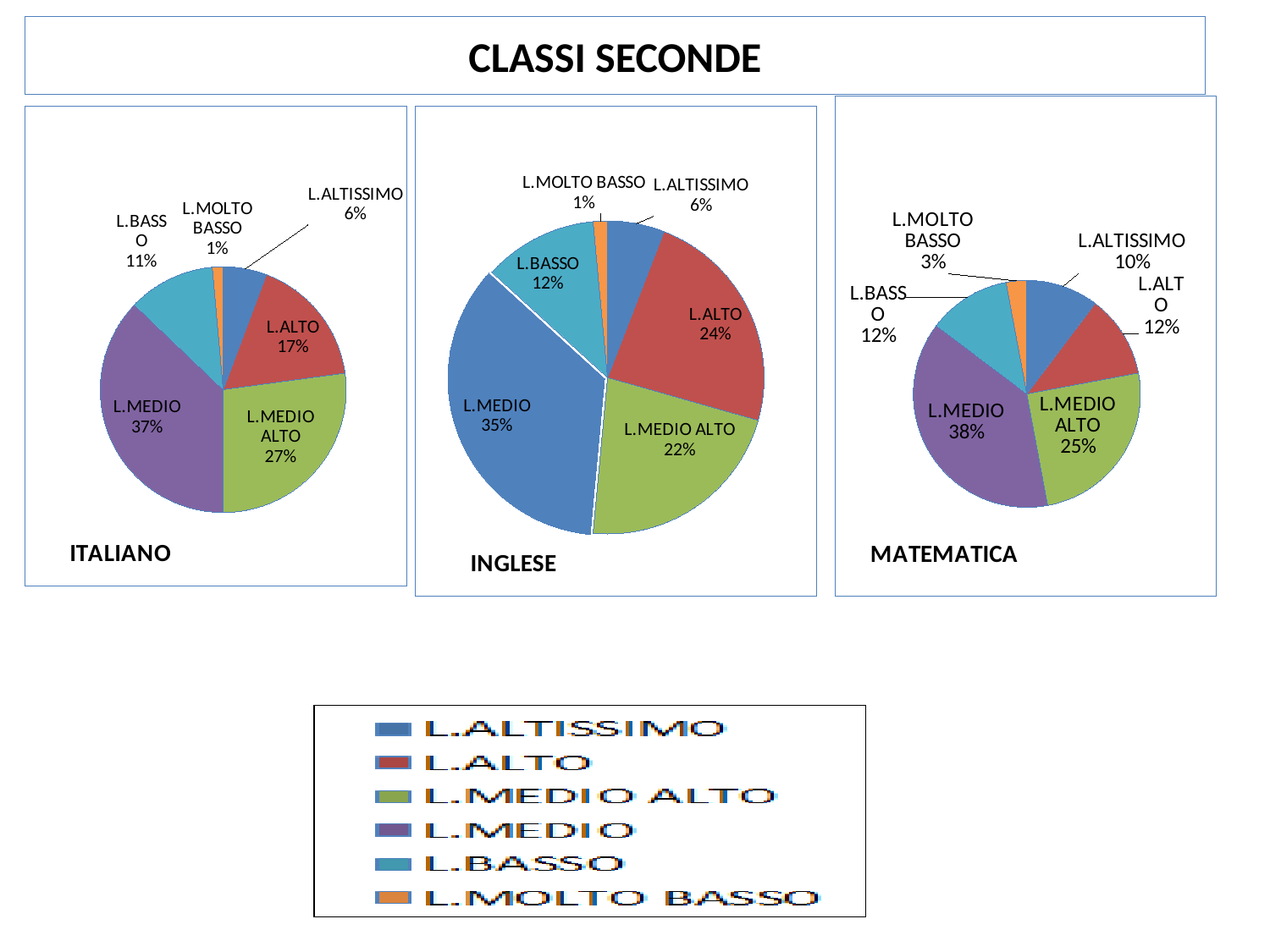
What type of chart is used for ITALIANO, INGLESE and MATEMATICA? Pie chart In the INGLESE pie chart, which category has the smallest share? L.MOLTO BASSO In the INGLESE pie chart, what share does L.ALTO have? 24% How many slices does the INGLESE pie chart have? 6 In the MATEMATICA pie chart, what is the difference between the shares of L.ALTISSIMO and L.MOLTO BASSO? 7% In the ITALIANO pie chart, what is the difference between the shares of L.MEDIO and L.MEDIO ALTO? 10% In the MATEMATICA pie chart, what share does L.MOLTO BASSO have? 3% In the MATEMATICA pie chart, which category has the largest share? L.MEDIO In the INGLESE pie chart, which is larger, L.ALTO or L.MEDIO ALTO? L.ALTO How many entries does the legend at the bottom of the slide list? 6 In the ITALIANO pie chart, what share does L.MEDIO have? 37% In the ITALIANO pie chart, which category has the largest share? L.MEDIO